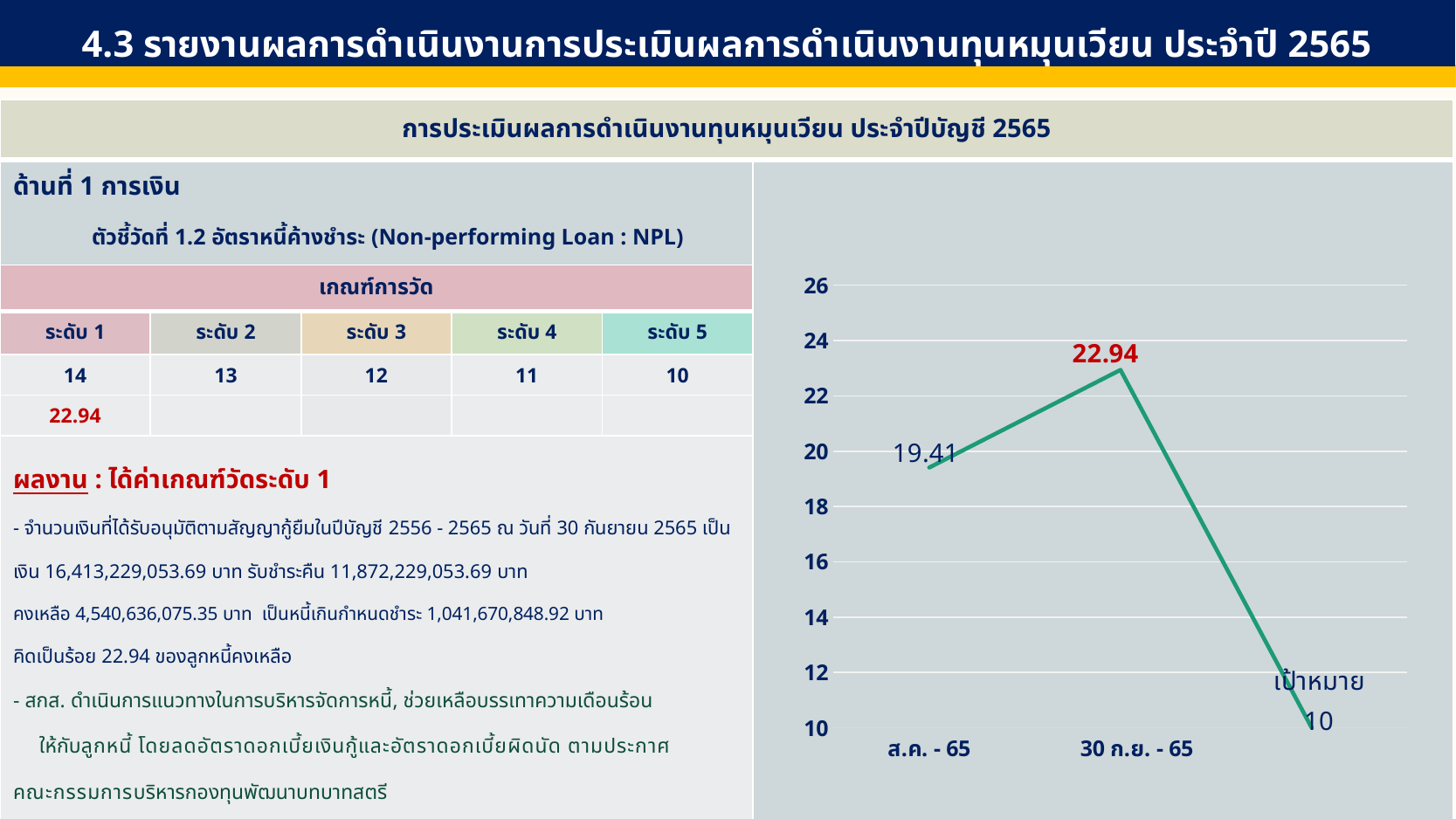
Does the line rise or fall between ส.ค. - 65 and 30 ก.ย. - 65? rise What is the value plotted for 30 ก.ย. - 65? 22.94 Which is larger, the value for ส.ค. - 65 or the value for 30 ก.ย. - 65? 30 ก.ย. - 65 Which point on the chart has the highest value? 30 ก.ย. - 65 What is the difference between the value for 30 ก.ย. - 65 and the value for ส.ค. - 65? 3.53 What kind of chart is shown on the slide? line chart What is the value plotted for ส.ค. - 65? 19.41 What is the value plotted for เป้าหมาย? 10 Which point on the chart has the lowest value? เป้าหมาย How many data points are plotted on the line? 3 What is the difference between the value for 30 ก.ย. - 65 and the เป้าหมาย value? 12.94 Is the value for ส.ค. - 65 greater or less than 20? less